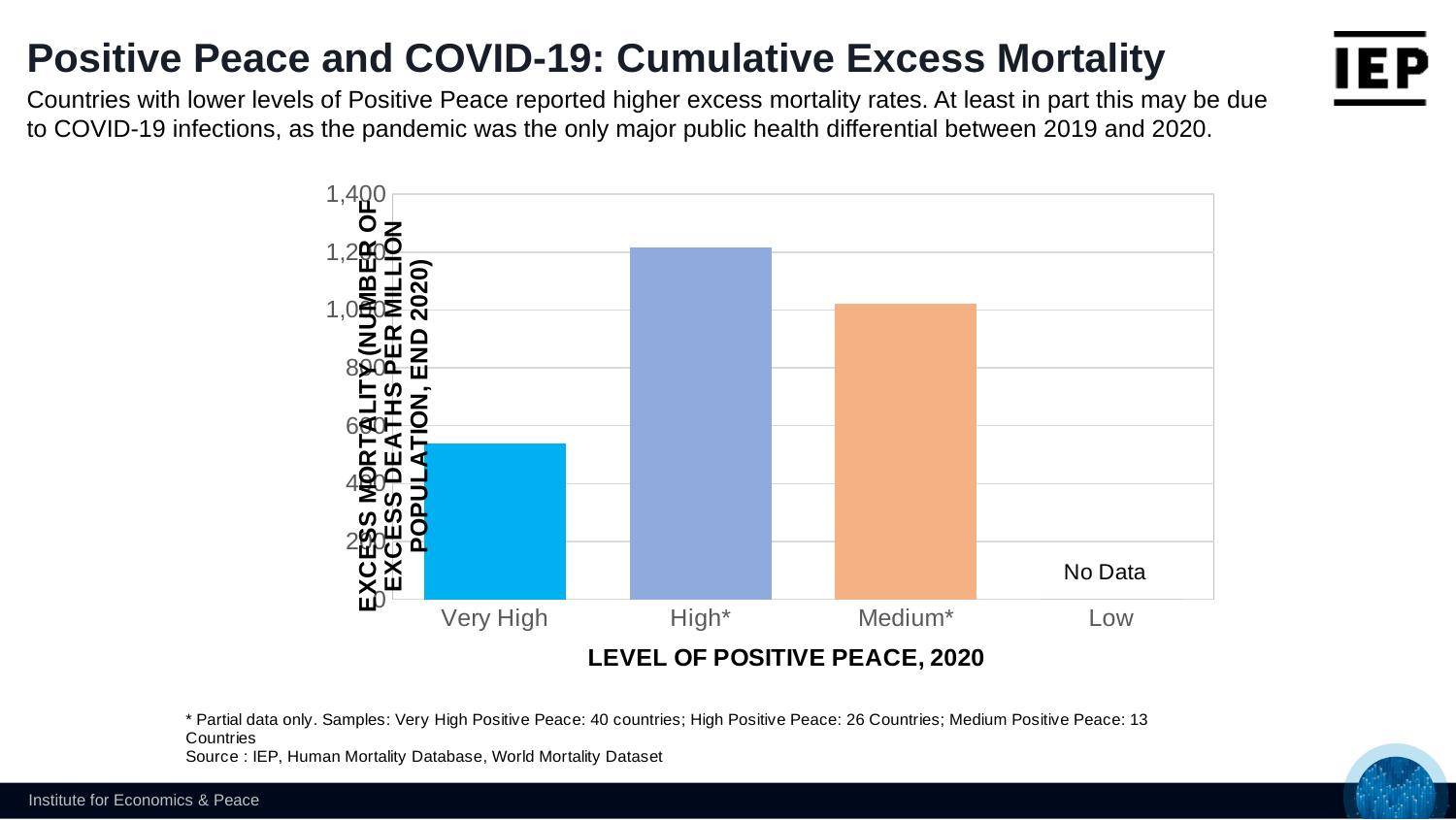
Is the excess mortality value for Medium* greater or less than 800? greater Which category in the chart is marked as having no data? Low Is the excess mortality value for Very High greater or less than 600? less Which has the larger excess mortality value, High* or Medium*? High* How many categories are shown on the x axis of the chart? 4 What kind of chart is shown on the slide? bar chart Is the excess mortality value for Medium* greater or less than 1,200? less Among the categories with a plotted bar, which level of Positive Peace has the lowest excess mortality? Very High What is the title of the x axis of the chart? LEVEL OF POSITIVE PEACE, 2020 Which level of Positive Peace has the highest excess mortality in the chart? High*